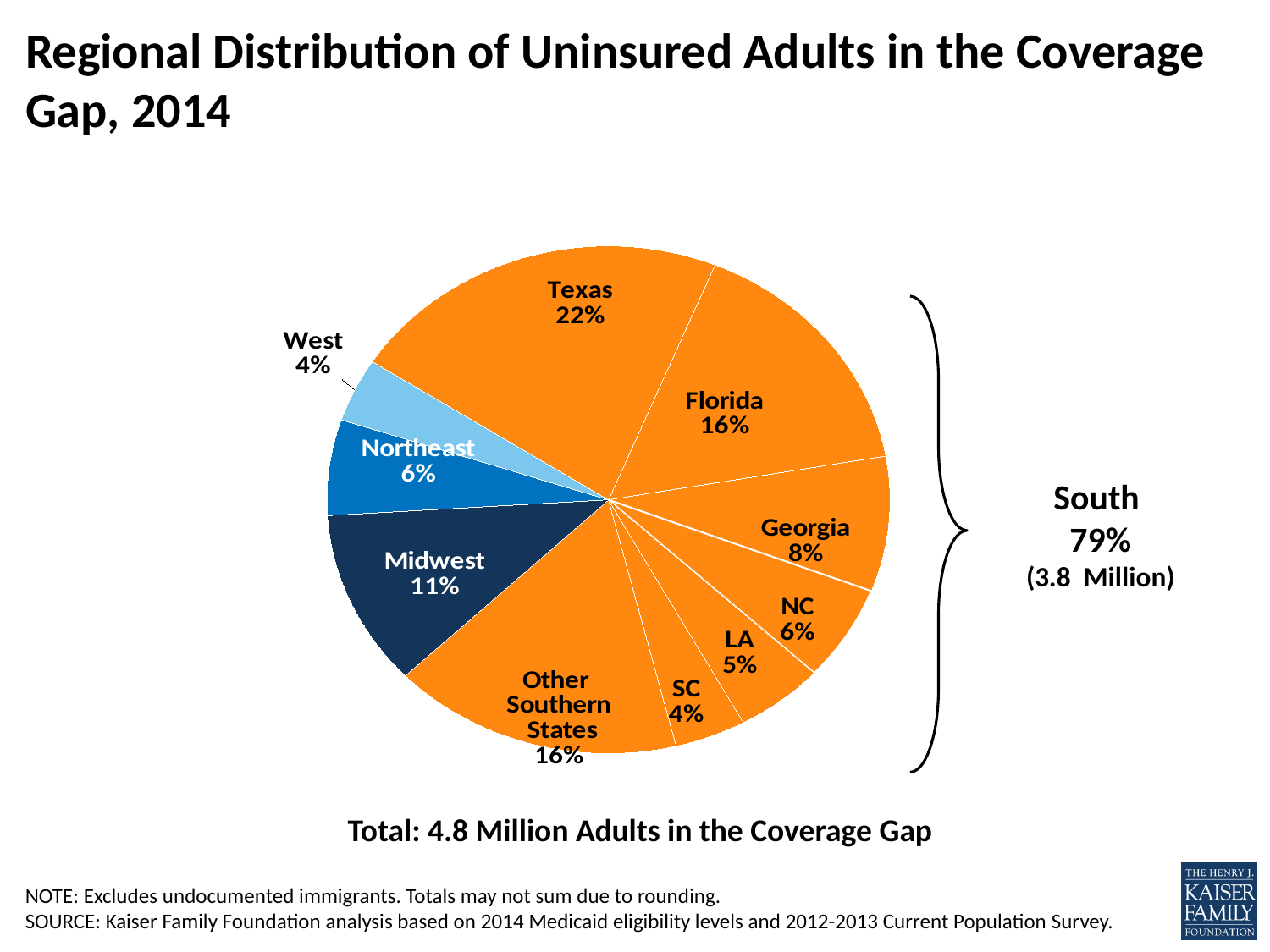
What kind of chart is shown on the slide? pie chart Which slice of the pie is the largest? Texas What is the title of the chart? Regional Distribution of Uninsured Adults in the Coverage Gap, 2014 What is the difference between the NC share and the SC share? 2% What share of the pie is labelled Midwest? 11% How many slices does the pie chart have? 10 What is the combined share for the South region shown next to the bracket? 79% Which is larger, the Midwest share or the Northeast share? Midwest What is the difference between the Texas share and the Florida share? 6% What share of uninsured adults in the coverage gap is in Texas? 22% What total number of adults in the coverage gap is stated below the chart? 4.8 Million What percentage is shown for Georgia? 8%